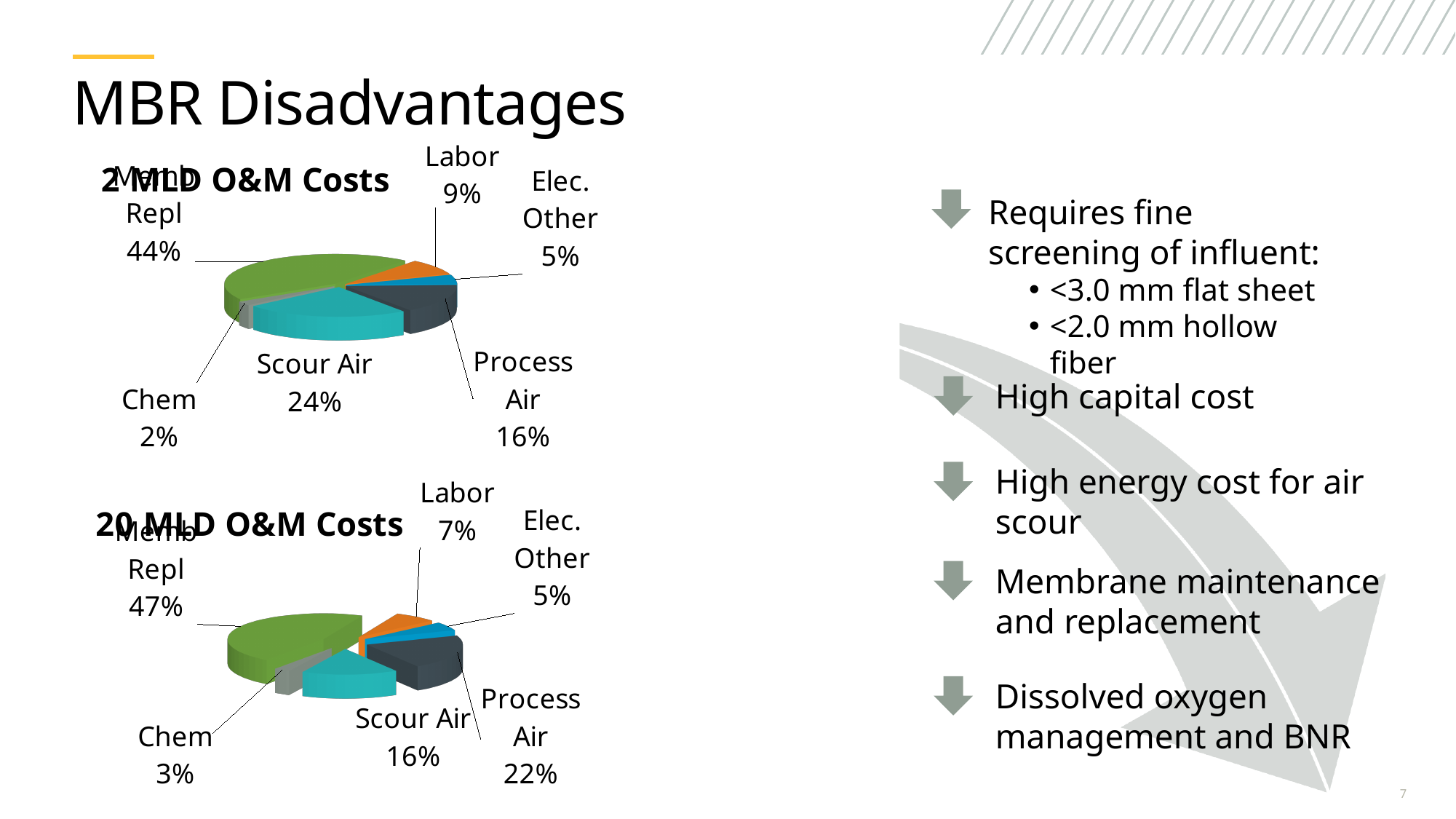
In the 20 MLD O&M Costs chart, which category has the smallest share? Chem In the 2 MLD O&M Costs chart, what is the difference between the Scour Air and Process Air shares? 8% In the 20 MLD O&M Costs chart, what is the difference between the Memb Repl and Labor shares? 40% In the 20 MLD O&M Costs chart, what share is Process Air? 22% In the 2 MLD O&M Costs chart, which category has the largest share? Memb Repl What type of chart is the 20 MLD O&M Costs chart? Pie chart In the 20 MLD O&M Costs chart, which is larger, Process Air or Scour Air? Process Air What is the title of the top chart on the slide? 2 MLD O&M Costs In the 20 MLD O&M Costs chart, what share is Memb Repl? 47% In the 2 MLD O&M Costs chart, what share is Labor? 9% In the 2 MLD O&M Costs chart, what share is Scour Air? 24% How many categories are shown in the 2 MLD O&M Costs chart? 6